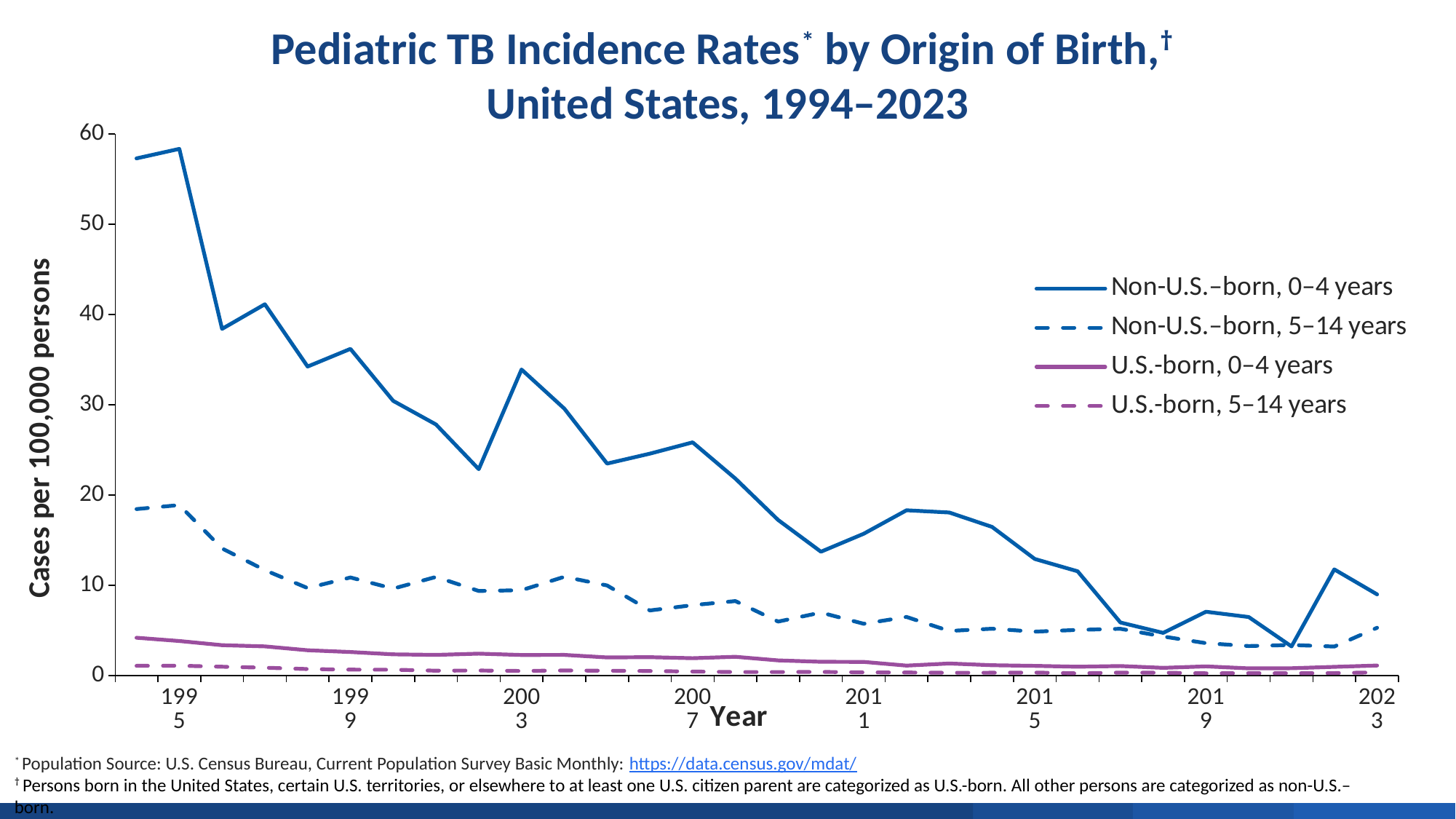
Which series has the lowest values across the whole period? U.S.-born, 5–14 years Which series has the highest values across the whole period? Non-U.S.–born, 0–4 years In 1995, which is larger: the value for Non-U.S.–born, 0–4 years or for U.S.-born, 0–4 years? Non-U.S.–born, 0–4 years Is the value for U.S.-born, 0–4 years in 1995 greater or less than 10? less Is the value for Non-U.S.–born, 0–4 years in 1995 greater or less than 50? greater Is the value for Non-U.S.–born, 5–14 years in 1999 greater or less than 20? less What is the label of the vertical axis? Cases per 100,000 persons What kind of chart is shown on the slide? Line chart What is the title of the chart? Pediatric TB Incidence Rates by Origin of Birth, United States, 1994–2023 Does the Non-U.S.–born, 0–4 years line generally rise or fall from 1994 to 2023? Fall How many series does the legend list? 4